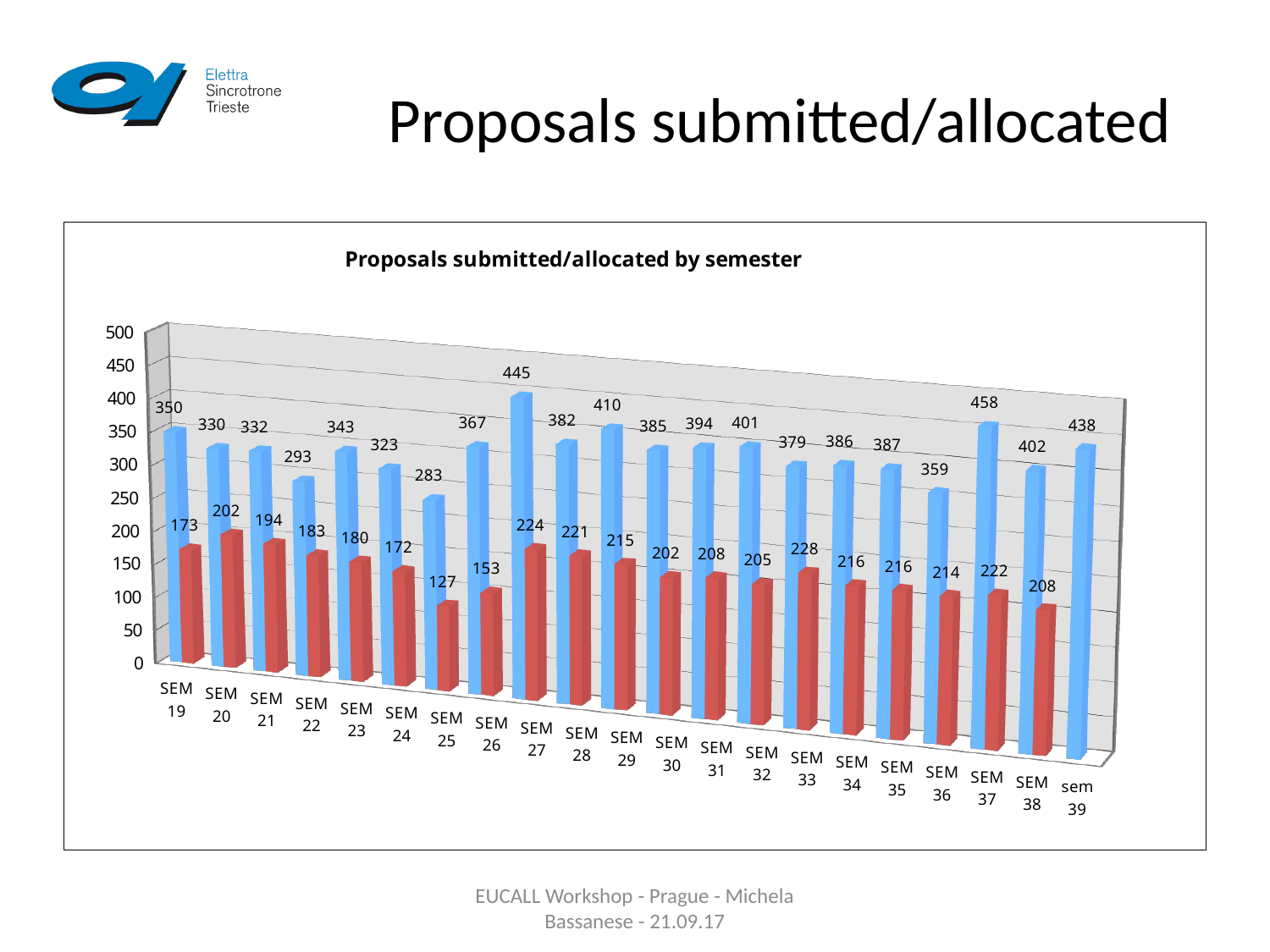
Which semester has the lowest red bar? SEM 25 What is the difference between the blue bar and the red bar for SEM 37? 236 Which semester has the lowest blue bar? SEM 25 What is the title of the chart? Proposals submitted/allocated by semester What kind of chart is shown on the slide? bar chart What is the value of the red bar for SEM 26? 153 Which semester has the highest blue bar? SEM 37 Is the value of the red bar for SEM 25 greater or less than 150? less Which semester has the highest red bar? SEM 33 What is the value of the blue bar for SEM 27? 445 How many semesters are shown along the x axis of the chart? 21 Which has the larger blue bar, SEM 29 or SEM 31? SEM 29